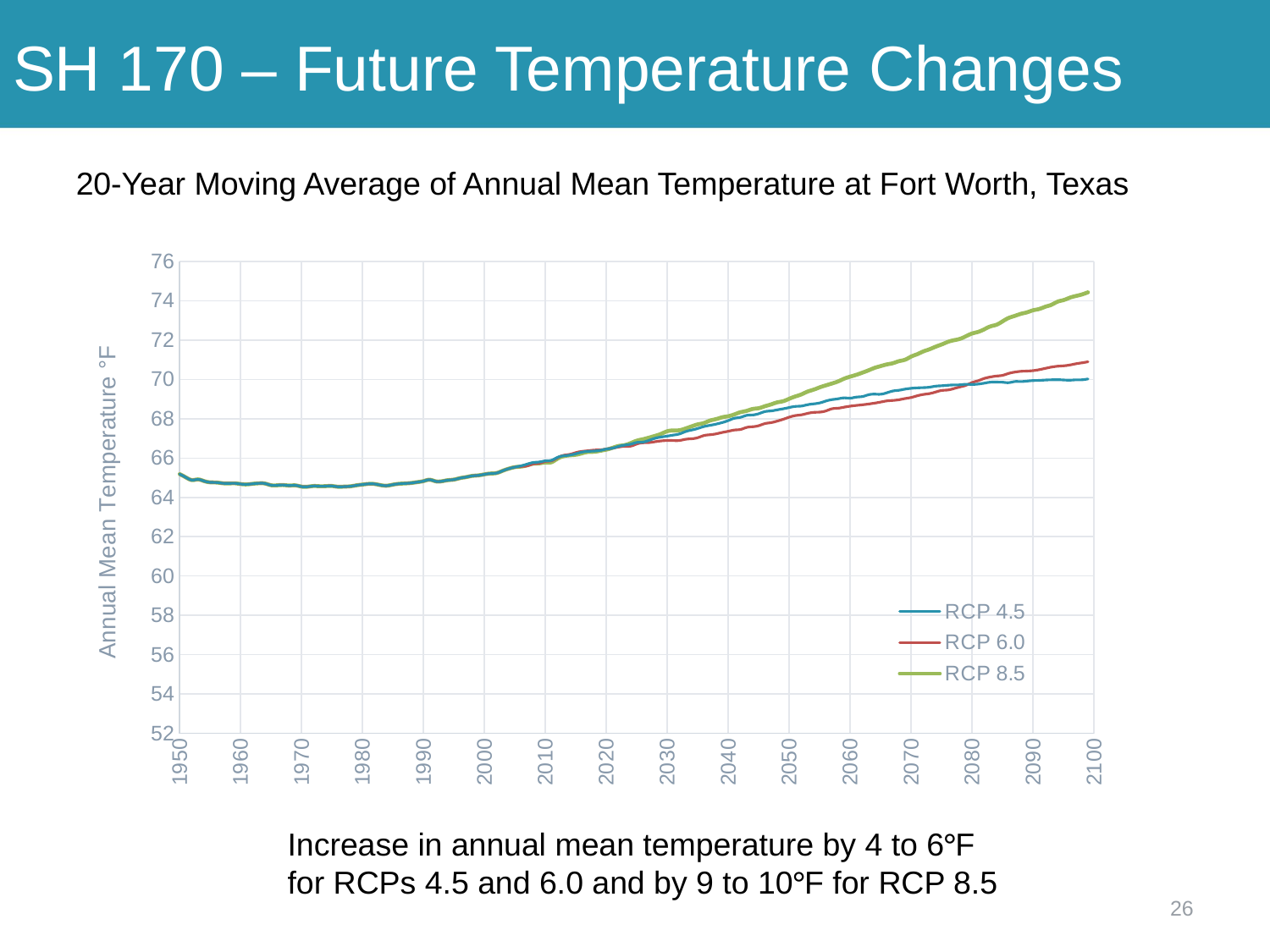
How many series does the legend list? 3 What colour is the line for RCP 8.5? green Is the value for RCP 6.0 at 2100 greater or less than 72? less Which series has the lowest value at 2100? RCP 4.5 What is the label on the vertical axis? Annual Mean Temperature °F Is the value for RCP 8.5 at 2100 greater or less than 72? greater Is the value for RCP 4.5 at 2100 greater or less than 68? greater Which series has the highest value at 2100? RCP 8.5 What kind of chart is shown on the slide? line chart At 2100, which is larger: the value for RCP 6.0 or the value for RCP 4.5? RCP 6.0 Do the values for RCP 8.5 rise or fall between 2020 and 2100? rise